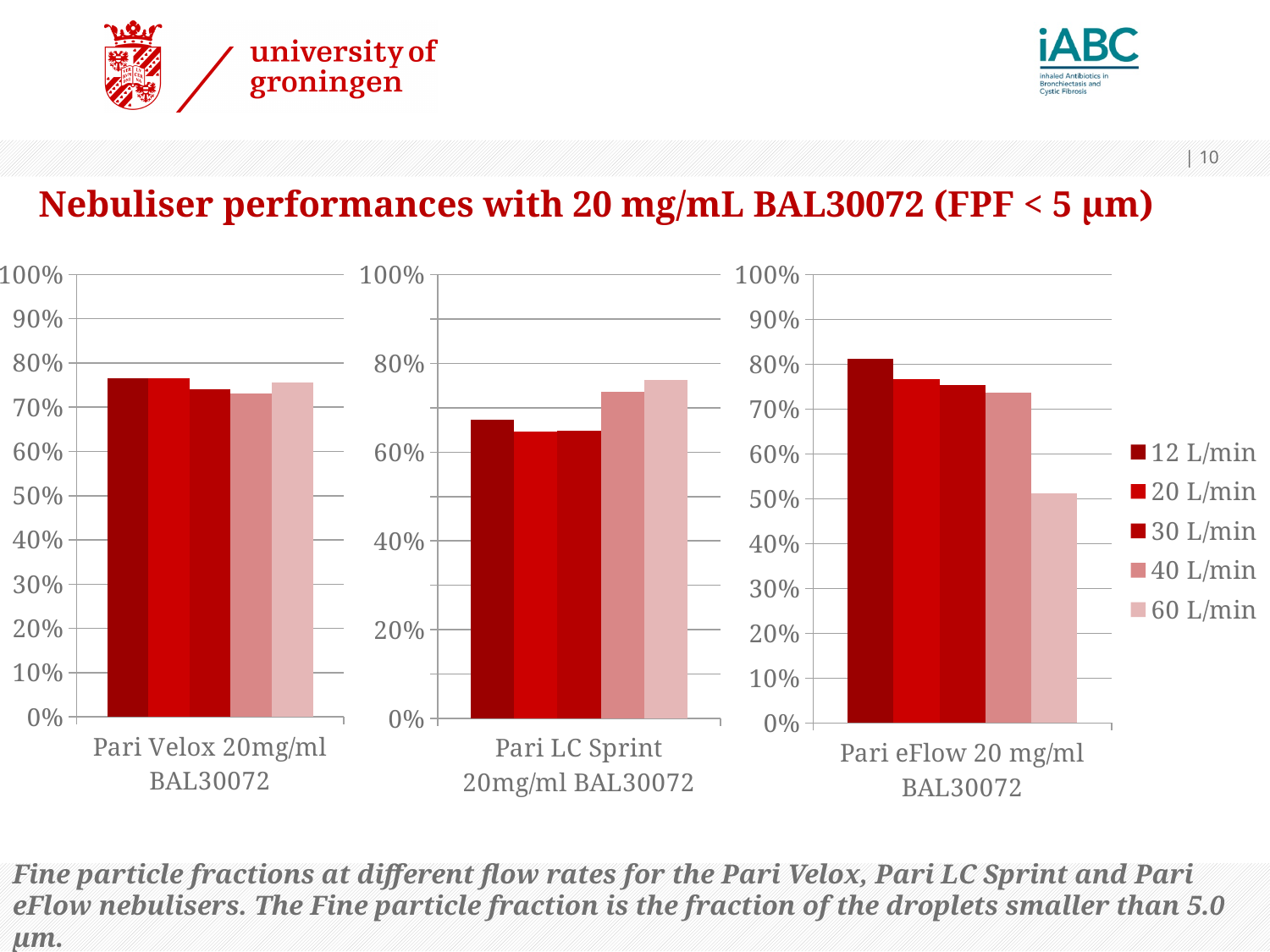
How many flow-rate series does the legend list? 5 In the Pari eFlow 20 mg/ml BAL30072 chart on the right, which flow rate has the lowest fine particle fraction? 60 L/min In the Pari LC Sprint 20mg/ml BAL30072 chart in the middle, which flow rate has the highest fine particle fraction? 60 L/min In the Pari Velox 20mg/ml BAL30072 chart on the left, is the value for 40 L/min greater or less than 80%? less In the Pari eFlow 20 mg/ml BAL30072 chart on the right, which flow rate has the highest fine particle fraction? 12 L/min In the Pari eFlow 20 mg/ml BAL30072 chart on the right, is the value for 60 L/min greater or less than 60%? less In the Pari Velox 20mg/ml BAL30072 chart on the left, is the value for 12 L/min greater or less than 70%? greater What is the title of the slide above the three charts? Nebuliser performances with 20 mg/mL BAL30072 (FPF < 5 µm) In the Pari LC Sprint 20mg/ml BAL30072 chart in the middle, which is larger, the value for 60 L/min or the value for 20 L/min? 60 L/min What kind of chart is used for the Pari Velox 20mg/ml BAL30072 chart on the left? Bar chart